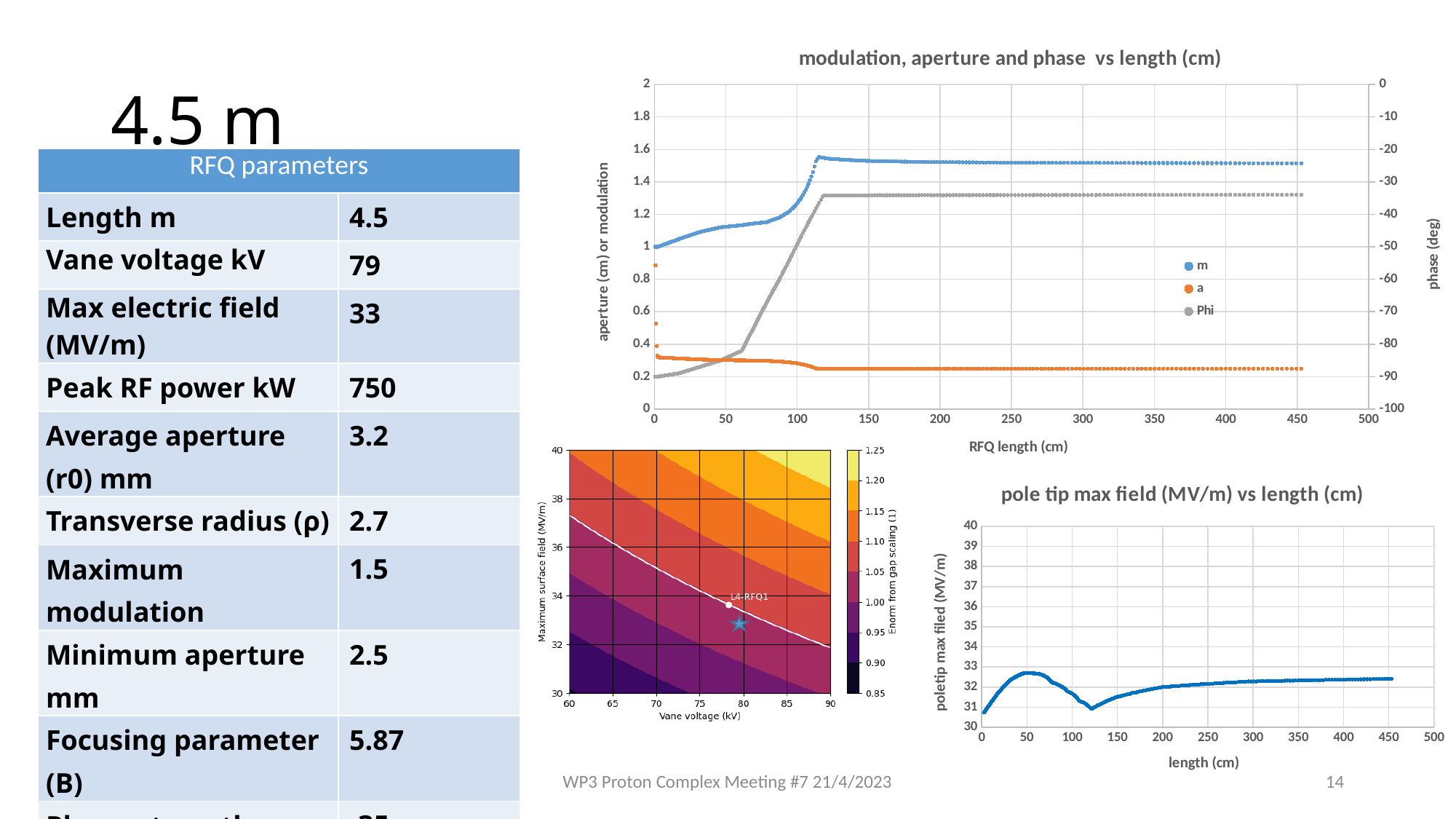
What kind of chart is the 'modulation, aperture and phase vs length (cm)' chart? scatter chart In the 'pole tip max field (MV/m) vs length (cm)' chart, is the value at 450 cm greater or less than 32? greater In the 'modulation, aperture and phase vs length (cm)' chart, is the value of series m at 450 cm greater or less than 1.4? greater How many series does the legend of the 'modulation, aperture and phase vs length (cm)' chart list? 3 In the 'pole tip max field (MV/m) vs length (cm)' chart, is the value at 0 cm greater or less than 31? less In the 'pole tip max field (MV/m) vs length (cm)' chart, does the value rise or fall between 150 cm and 450 cm? rise In the 'modulation, aperture and phase vs length (cm)' chart, what are the three legend entries? m, a, Phi In the 'modulation, aperture and phase vs length (cm)' chart, does series a rise or fall between 0 and 150 cm? fall What kind of chart is the 'pole tip max field (MV/m) vs length (cm)' chart? line chart In the 'modulation, aperture and phase vs length (cm)' chart, does series m rise or fall between 0 and 100 cm? rise What is the x-axis title of the contour plot at the bottom middle of the slide? Vane voltage (kV)